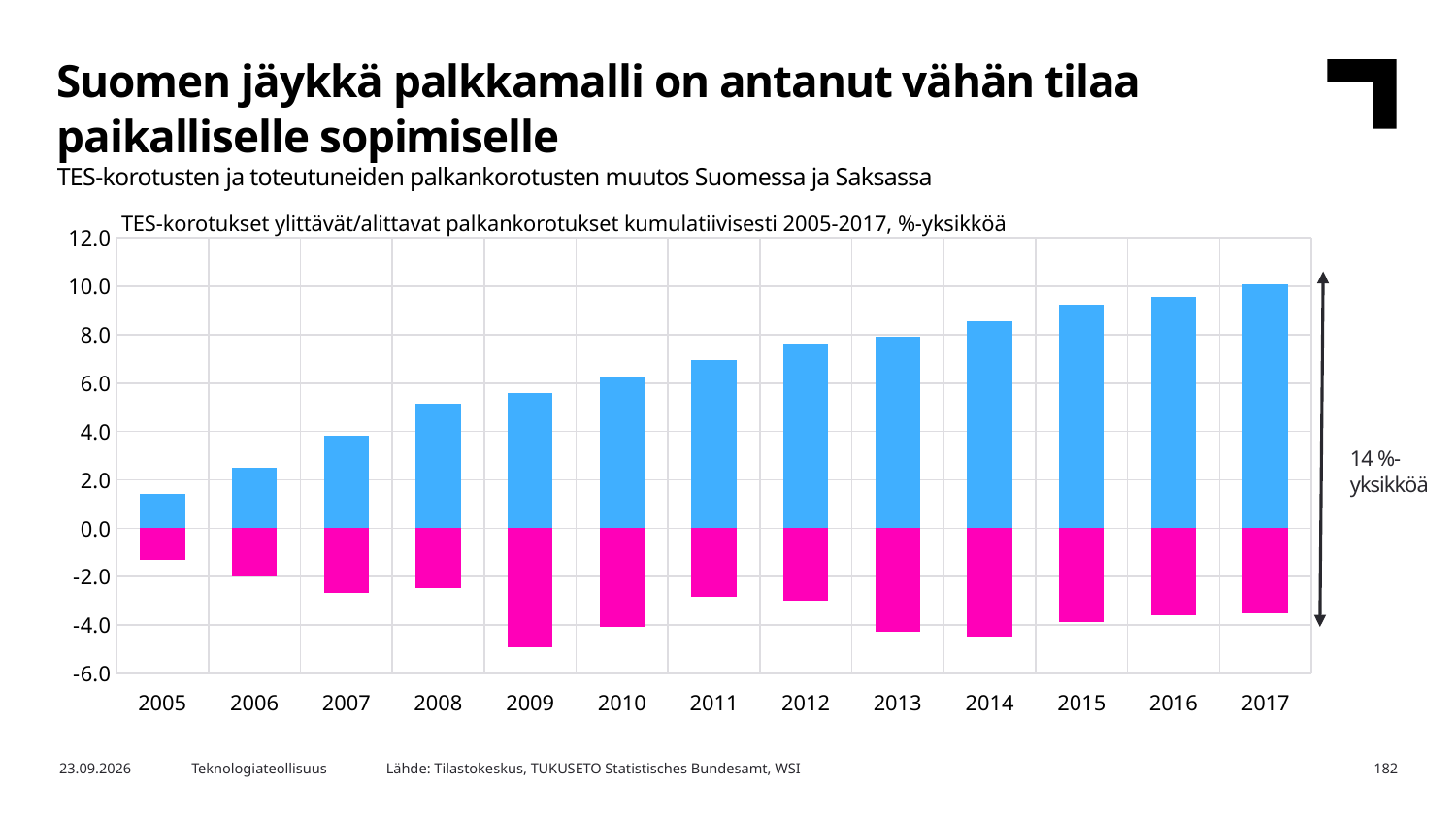
Which year has the magenta (negative) bar that extends furthest below zero? 2009 Which year has the smallest magenta (negative) bar? 2005 Which year has the shortest blue (positive) bar? 2005 How many years are shown on the x axis of the chart? 13 What value does the annotation with the arrow to the right of the 2017 bars state? 14 %-yksikköä Is the blue bar for 2015 greater or less than 8.0? greater What kind of chart is shown on the slide? bar chart Which year has the larger blue bar, 2010 or 2012? 2012 Is the blue bar for 2008 greater or less than 4.0? greater Do the blue (positive) bars rise or fall from 2005 to 2017? rise Which year has the tallest blue (positive) bar? 2017 Is the magenta bar for 2009 greater or less than -4.0? less